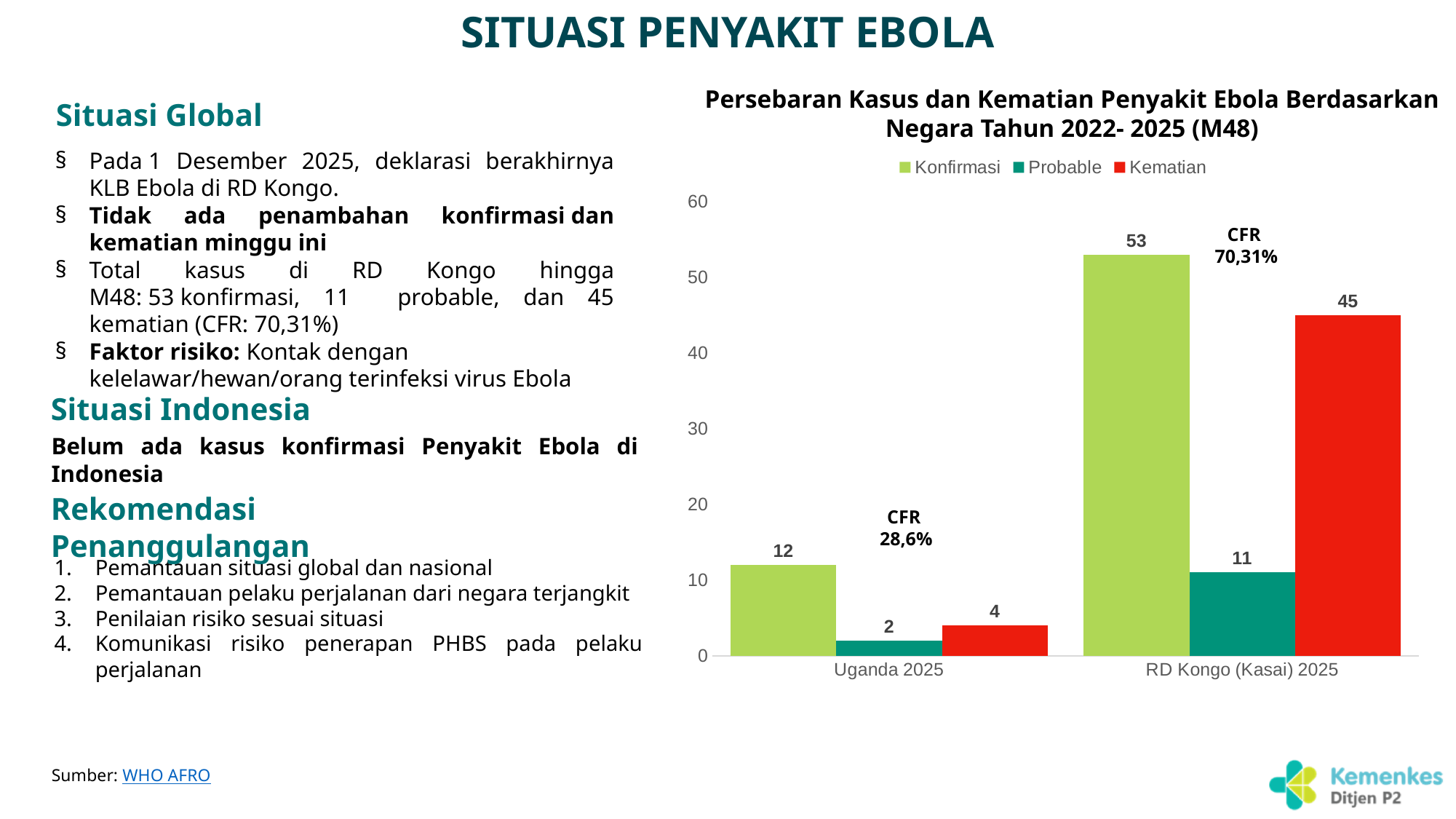
What is the Konfirmasi value for RD Kongo (Kasai) 2025? 53 What kind of chart is shown on the slide? Bar chart How many countries (categories) are shown on the x axis? 2 What is the Konfirmasi value for Uganda 2025? 12 Which country has the highest Kematian value? RD Kongo (Kasai) 2025 How many series does the legend list? 3 What is the Probable value for RD Kongo (Kasai) 2025? 11 What CFR is shown above the bars for RD Kongo (Kasai) 2025? 70,31% Which is larger: the Kematian value for RD Kongo (Kasai) 2025 or the Konfirmasi value for Uganda 2025? Kematian for RD Kongo (Kasai) 2025 What is the difference between the Konfirmasi values for RD Kongo (Kasai) 2025 and Uganda 2025? 41 What is the Kematian value for Uganda 2025? 4 Which series has the lowest value for Uganda 2025? Probable